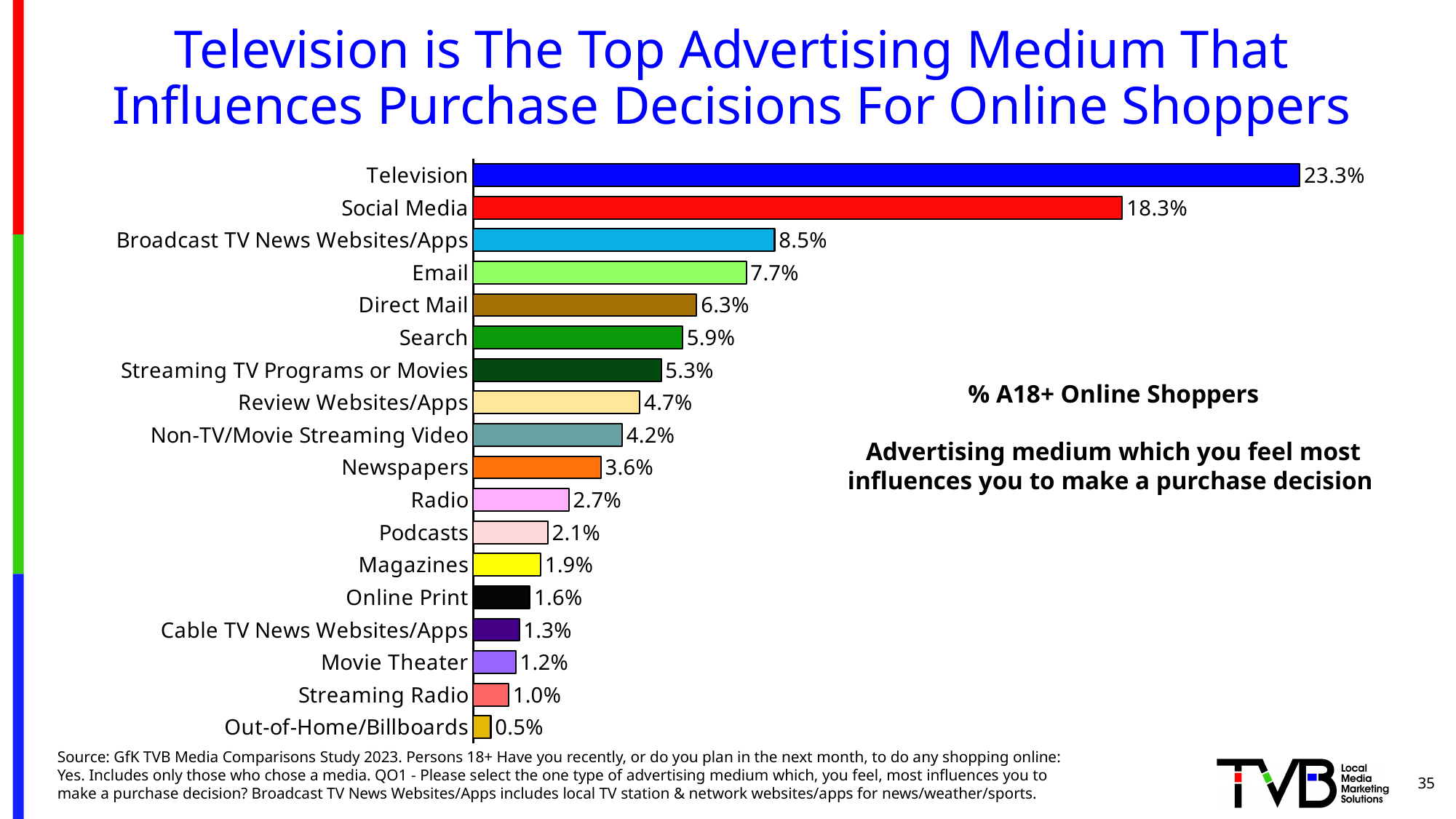
What percentage of A18+ online shoppers chose Television as the advertising medium that most influences their purchase decision? 23.3% Which advertising medium has the highest value on the chart? Television Which has a larger value, Search or Newspapers? Search What is the difference in percentage points between Email and Direct Mail? 1.4 What is the difference in percentage points between Television and Social Media? 5.0 Which advertising medium has the lowest value on the chart? Out-of-Home/Billboards What colour is the bar for Magazines? Yellow How many advertising media categories are shown on the chart? 18 What is the value shown for Social Media? 18.3% What is the value shown for Streaming TV Programs or Movies? 5.3% What is the value shown for Podcasts? 2.1% What type of chart is shown on the slide? Bar chart